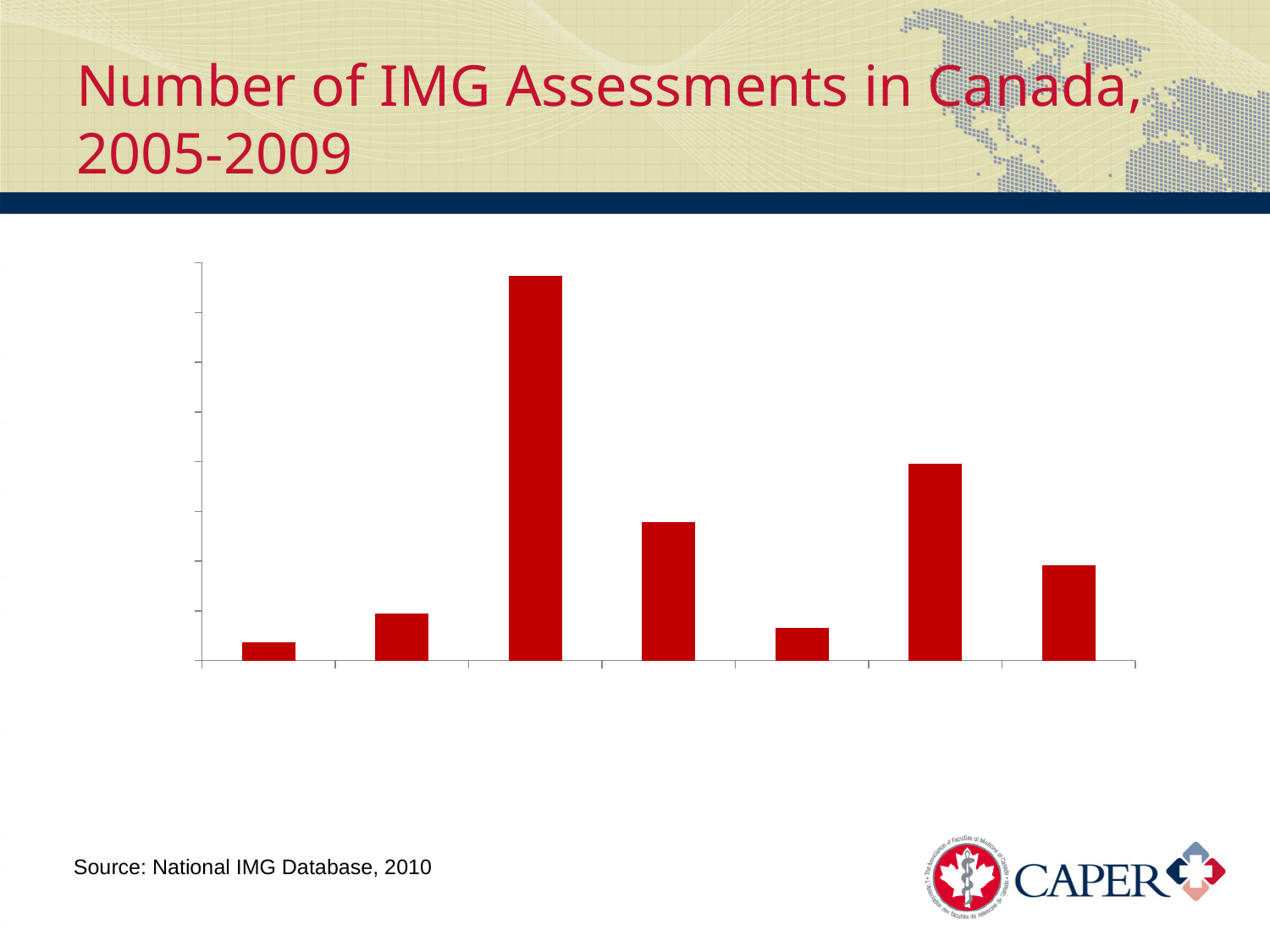
What colour are the bars in the chart? red Which is taller in the chart: the fourth bar from the left or the seventh bar from the left? the fourth bar Counting from the left, which bar in the chart is the tallest? the third bar Counting from the left, which bar in the chart is the shortest? the first bar Which is taller in the chart: the second bar from the left or the fifth bar from the left? the second bar What kind of chart is shown on the slide? bar chart What is the title of the slide containing the chart? Number of IMG Assessments in Canada, 2005-2009 Which is taller in the chart: the third bar from the left or the sixth bar from the left? the third bar How many bars are plotted in the chart? 7